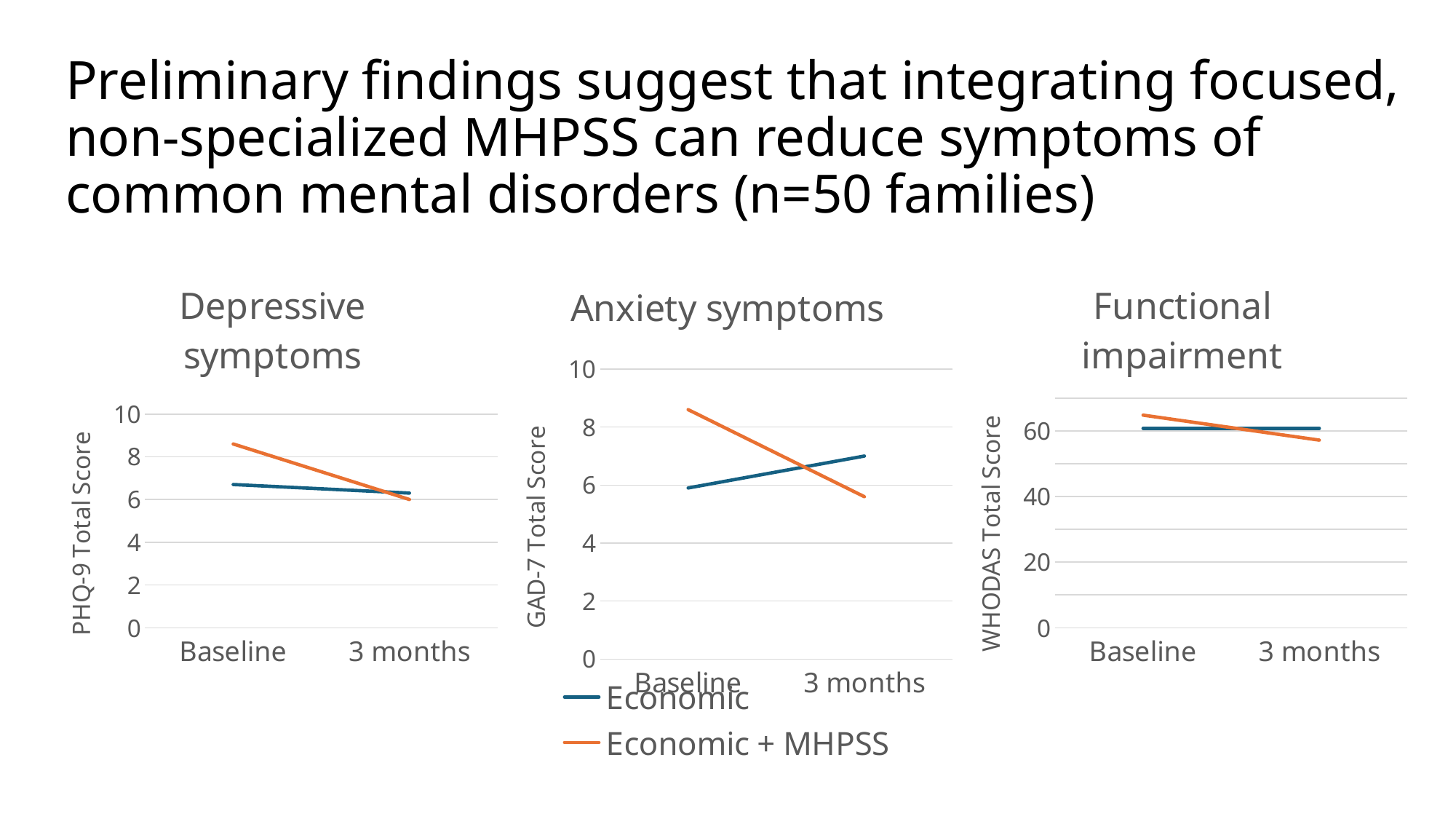
In the Functional impairment chart, is the 3 months value for Economic + MHPSS greater or less than 60? less What kind of chart is the Depressive symptoms chart? line chart In the Depressive symptoms chart, does the Economic + MHPSS line rise or fall from Baseline to 3 months? fall In the Anxiety symptoms chart, is the 3 months value for Economic + MHPSS greater or less than 6? less How many series does the legend list? 2 In the Anxiety symptoms chart, which series has the higher value at 3 months, Economic or Economic + MHPSS? Economic What is the y-axis label of the Functional impairment chart? WHODAS Total Score How many time points are shown on the x axis of the Anxiety symptoms chart? 2 In the Depressive symptoms chart, is the Baseline value for Economic + MHPSS greater or less than 8? greater In the Depressive symptoms chart, which series has the higher value at Baseline, Economic or Economic + MHPSS? Economic + MHPSS In the Anxiety symptoms chart, does the Economic line rise or fall from Baseline to 3 months? rise In the Functional impairment chart, does the Economic + MHPSS line rise or fall from Baseline to 3 months? fall